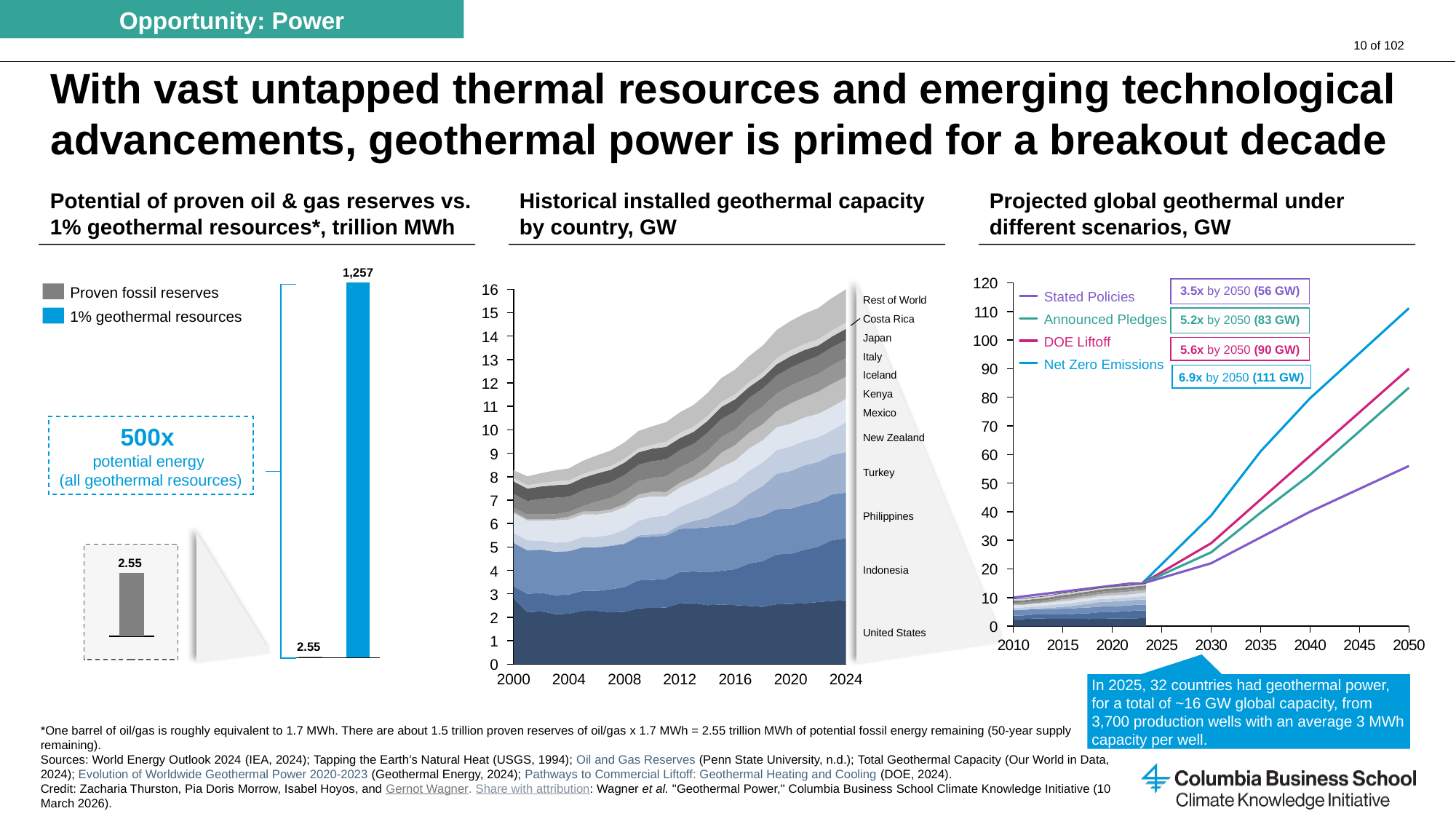
In the chart 'Historical installed geothermal capacity by country, GW', is the total capacity in 2024 greater or less than 10 GW? Greater What kind of chart is 'Potential of proven oil & gas reserves vs. 1% geothermal resources'? Bar chart In the chart 'Projected global geothermal under different scenarios, GW', which scenario has the highest value in 2050? Net Zero Emissions How many scenarios does the legend list in the chart 'Projected global geothermal under different scenarios, GW'? 4 What kind of chart is 'Historical installed geothermal capacity by country, GW'? Stacked area chart In the chart 'Potential of proven oil & gas reserves vs. 1% geothermal resources', what is the value for 1% geothermal resources? 1,257 In the chart 'Potential of proven oil & gas reserves vs. 1% geothermal resources', what is the value for proven fossil reserves? 2.55 In the chart 'Potential of proven oil & gas reserves vs. 1% geothermal resources', what is the difference between the 1% geothermal resources value and the proven fossil reserves value? 1,254.45 In the chart 'Historical installed geothermal capacity by country, GW', does total installed capacity rise or fall from 2000 to 2024? Rise In the chart 'Projected global geothermal under different scenarios, GW', what is the 2050 value for the Stated Policies scenario? 56 GW In the chart 'Potential of proven oil & gas reserves vs. 1% geothermal resources', which is larger: proven fossil reserves or 1% geothermal resources? 1% geothermal resources In the chart 'Historical installed geothermal capacity by country, GW', how many country/region series are labelled? 12